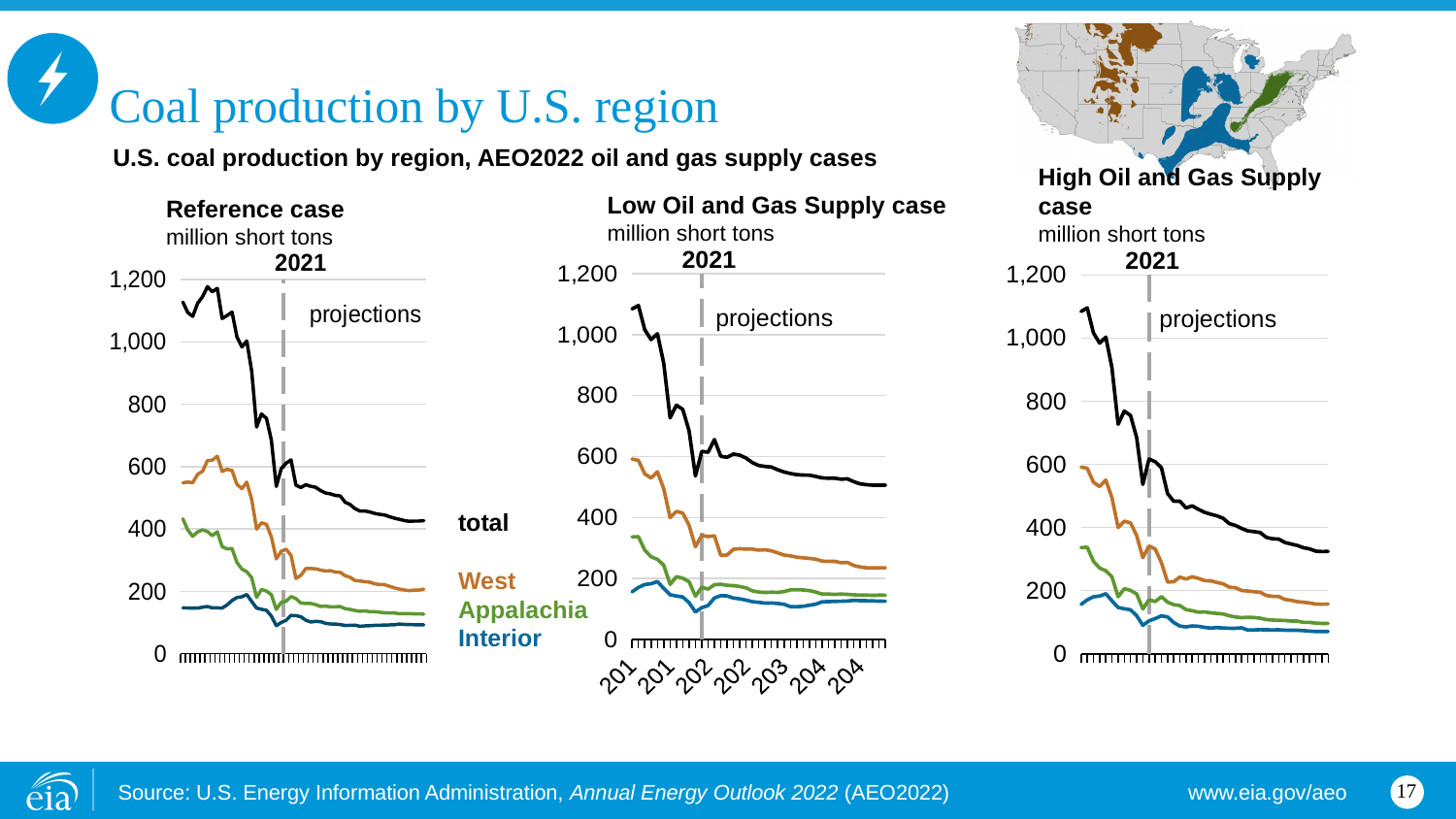
Which year does the dashed vertical line mark as the start of projections in each chart? 2021 In the Reference case chart, which region has higher production at the end of the projection, West or Appalachia? West How many charts are shown on the slide? 3 In the High Oil and Gas Supply case chart, is the total production at the end of the projection greater or less than 400? less In the Low Oil and Gas Supply case chart, which region has the lowest production at the end of the projection? Interior How many series does the legend list for the coal production charts? 4 In the Reference case chart, is the total production at the end of the projection greater or less than 600? less In the High Oil and Gas Supply case chart, which series has the highest values throughout? total In the Low Oil and Gas Supply case chart, is the total production at the end of the projection greater or less than 400? greater What unit is used on the y axis of the three charts? million short tons What kind of chart is used in the Reference case panel? line chart In the Reference case chart, does the total coal production rise or fall over the projection period? fall